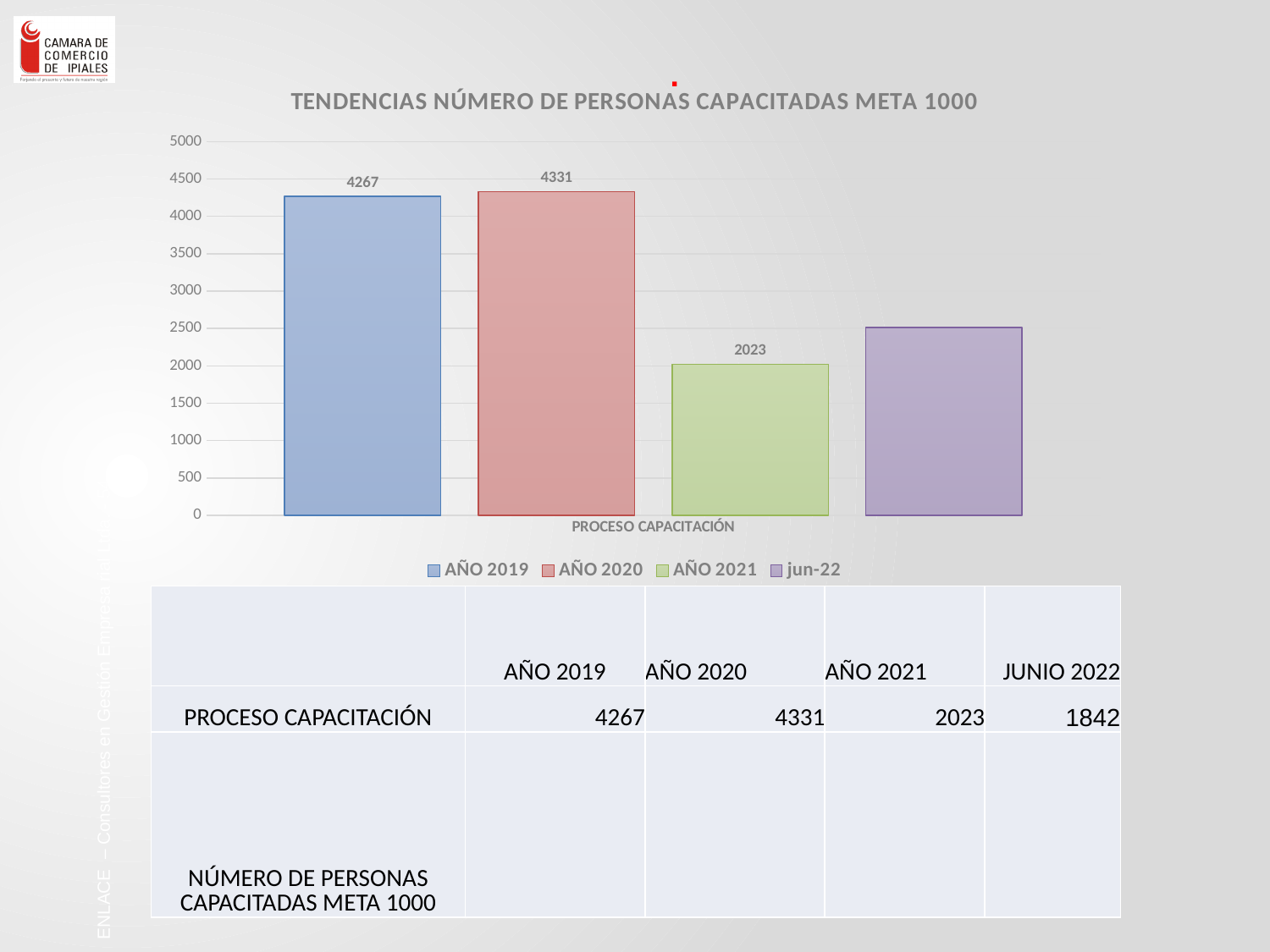
Which series has the highest value in the chart? AÑO 2020 Which is larger, the value for AÑO 2019 or the value for AÑO 2021? AÑO 2019 What is the value for AÑO 2021 in the chart? 2023 What is the difference between the values for AÑO 2019 and AÑO 2021? 2244 Is the value for jun-22 in the chart greater or less than 2000? greater What is the value for AÑO 2019 in the chart? 4267 What is the difference between the values for AÑO 2020 and AÑO 2019? 64 How many series does the legend list? 4 Is the value for jun-22 in the chart greater or less than 3000? less What is the title of the chart? TENDENCIAS NÚMERO DE PERSONAS CAPACITADAS META 1000 What is the value for AÑO 2020 in the chart? 4331 What kind of chart is shown on the slide? bar chart